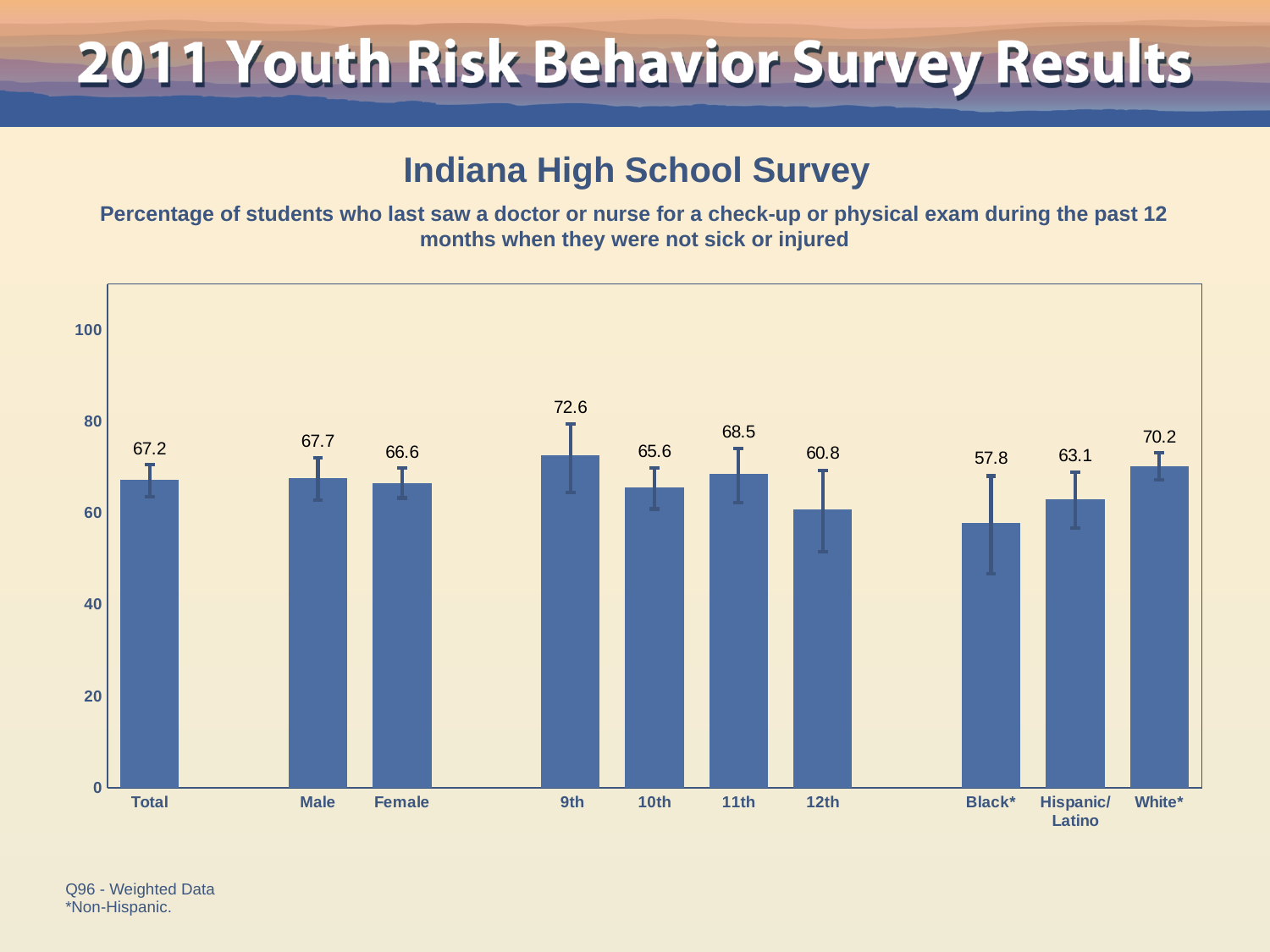
What kind of chart is this? bar chart What is the value for 9th grade students? 72.6 How many categories are shown on the x axis? 10 Which is larger, the value for 11th or the value for 12th? 11th What is the difference between the values for White* and Black*? 12.4 Which category has the highest value? 9th What is the value for Hispanic/Latino students? 63.1 Is the value for 12th greater or less than 80? less What is the difference between the values for Male and Female? 1.1 What is the title of the chart? Indiana High School Survey Which category has the lowest value? Black* What is the value for Total? 67.2